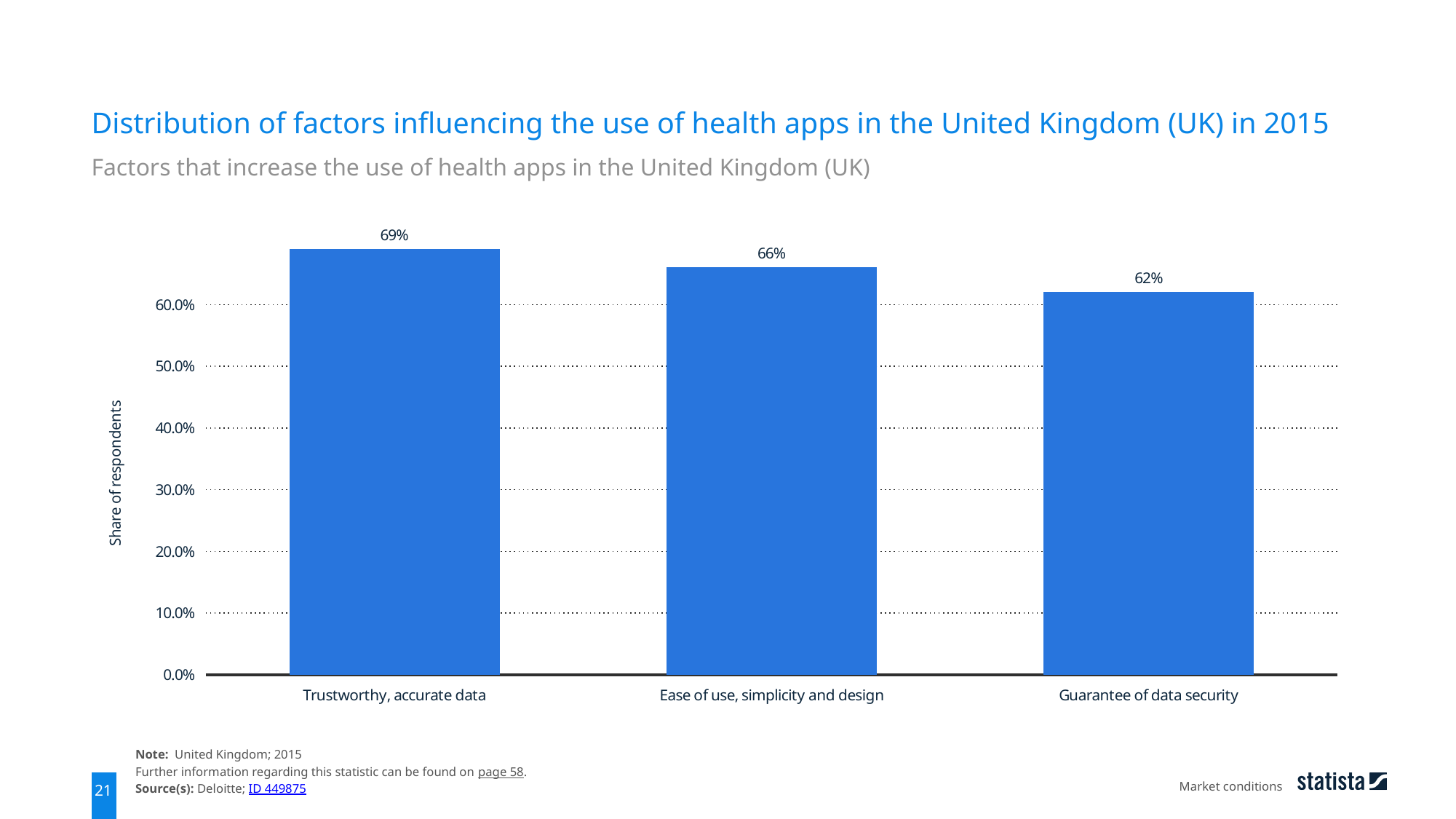
What is the difference in percentage points between "Ease of use, simplicity and design" and "Guarantee of data security"? 4 percentage points What is the share of respondents for "Ease of use, simplicity and design"? 66% What is the share of respondents for "Trustworthy, accurate data"? 69% What is the difference in percentage points between "Trustworthy, accurate data" and "Guarantee of data security"? 7 percentage points What is the share of respondents for "Guarantee of data security"? 62% Which factor has the highest share of respondents? Trustworthy, accurate data Which factor has the lowest share of respondents? Guarantee of data security How many factors are shown in the chart? 3 What is the label of the vertical axis? Share of respondents Is the value for "Guarantee of data security" greater or less than 60.0%? greater What kind of chart is shown on the slide? Bar chart Which has a larger share of respondents: "Trustworthy, accurate data" or "Ease of use, simplicity and design"? Trustworthy, accurate data